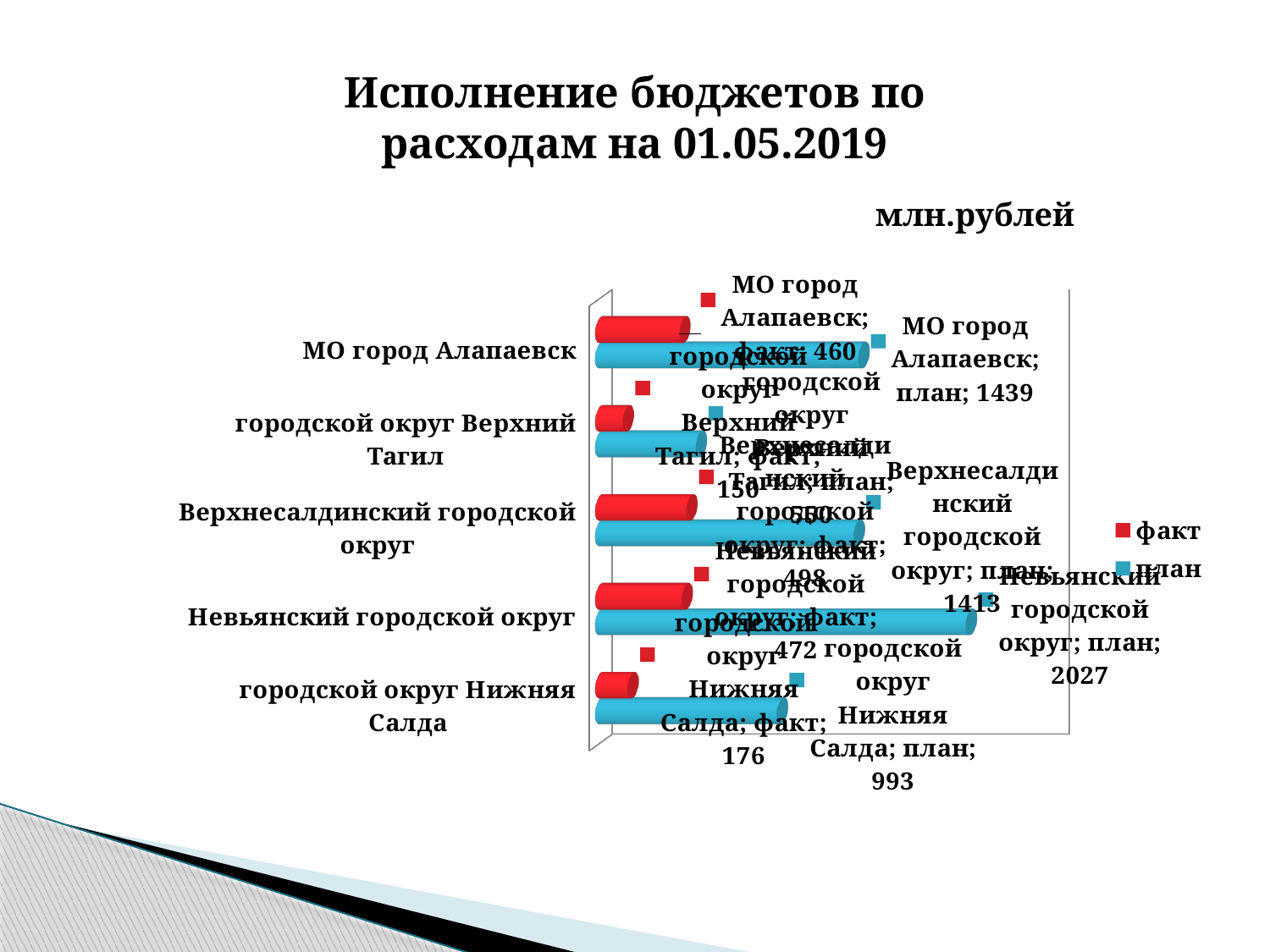
Which category has the lowest факт value? городской округ Верхний Тагил What is the difference between the план and факт values for МО город Алапаевск? 979 What is the факт value for Верхнесалдинский городской округ? 498 What is the факт value for МО город Алапаевск? 460 What is the факт value for городской округ Верхний Тагил? 150 What is the план value for МО город Алапаевск? 1439 Which has the larger факт value: Верхнесалдинский городской округ or Невьянский городской округ? Верхнесалдинский городской округ What is the план value for Невьянский городской округ? 2027 How many series does the legend list? 2 Which category has the highest план value? Невьянский городской округ What kind of chart is shown on the slide? bar chart What is the план value for городской округ Нижняя Салда? 993